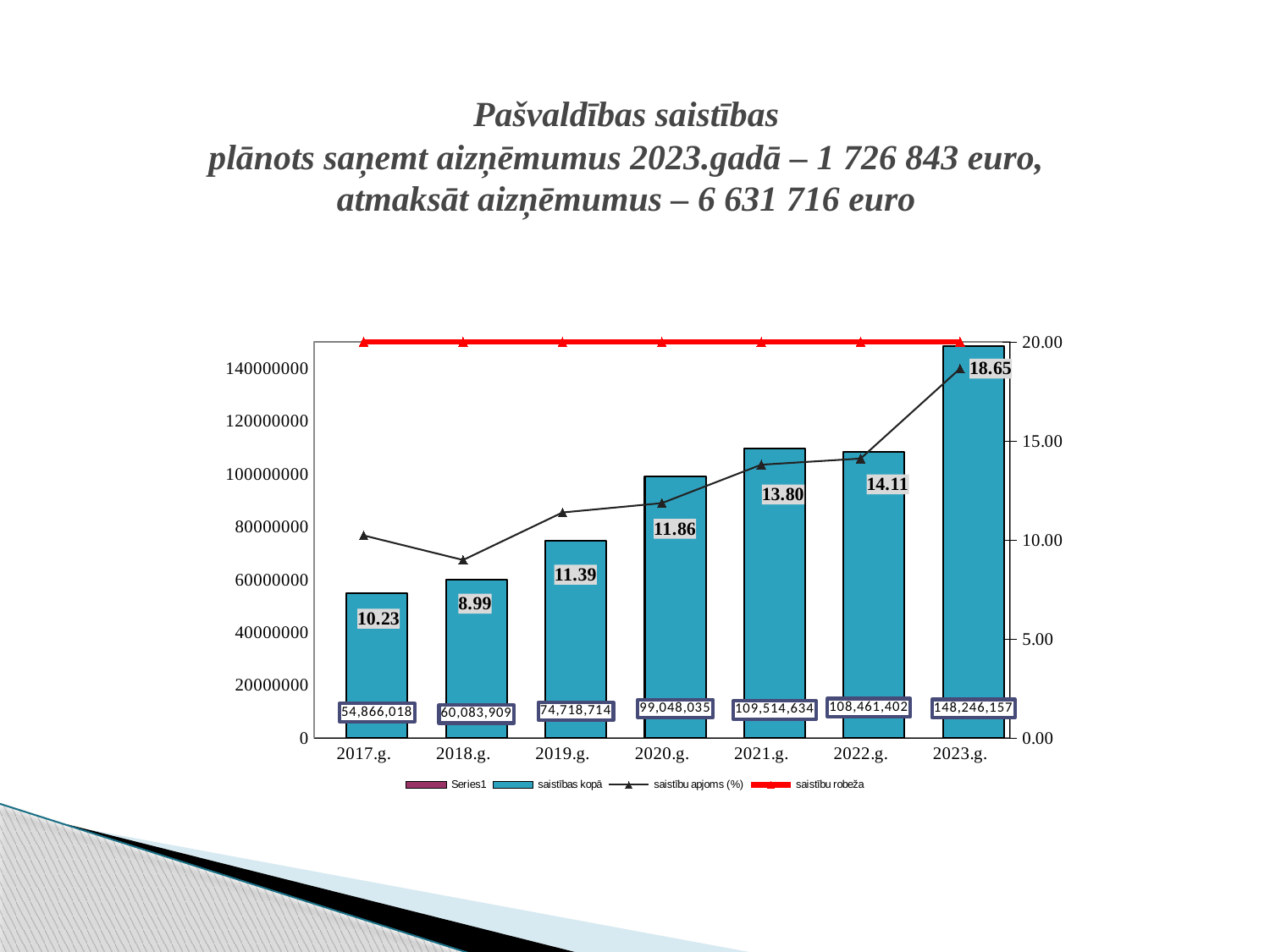
Is the 'saistības kopā' bar for 2019.g. greater or less than 80000000? less How many years are shown on the x axis? 7 Which is larger, the 'saistības kopā' value for 2021.g. or for 2022.g.? 2021.g. Which year has the highest 'saistības kopā' bar? 2023.g. What is the difference between the 'saistību apjoms (%)' values for 2023.g. and 2022.g.? 4.54 How many series does the legend list? 4 What is the value of 'saistības kopā' for 2023.g.? 148,246,157 Which year has the lowest 'saistību apjoms (%)' value? 2018.g. What kind of chart is used for the 'saistības kopā' series? bar chart Does the 'saistību apjoms (%)' line rise or fall from 2019.g. to 2023.g.? rise What is the value of 'saistības kopā' for 2020.g.? 99,048,035 What is the 'saistību apjoms (%)' value for 2018.g.? 8.99